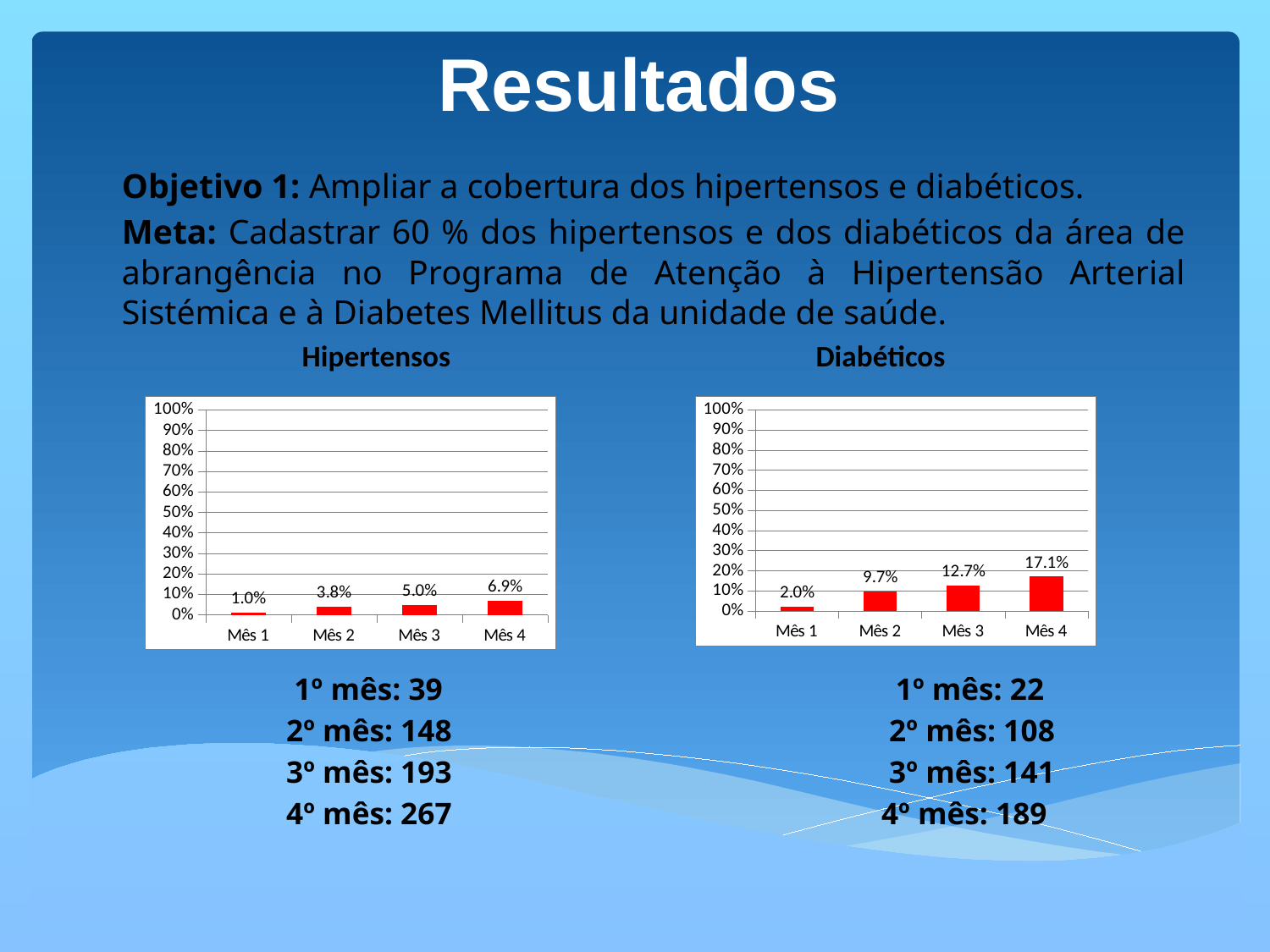
In the Diabéticos chart, is the value for Mês 4 greater or less than 20%? less In the Diabéticos chart, what is the difference between the values for Mês 4 and Mês 3? 4.4% In the Hipertensos chart, which month has the lowest value? Mês 1 In the Diabéticos chart, which month has the highest value? Mês 4 In the Diabéticos chart, what is the value for Mês 2? 9.7% In the Hipertensos chart, what is the difference between the values for Mês 2 and Mês 1? 2.8% In the Hipertensos chart, what is the value for Mês 1? 1.0% In the Hipertensos chart, what is the value for Mês 4? 6.9% Which is larger: the Mês 3 value in the Diabéticos chart or the Mês 3 value in the Hipertensos chart? Diabéticos How many months are shown on the x axis of the Hipertensos chart? 4 In the Hipertensos chart, do the values rise or fall from Mês 1 to Mês 4? rise What kind of chart is the Diabéticos chart? bar chart